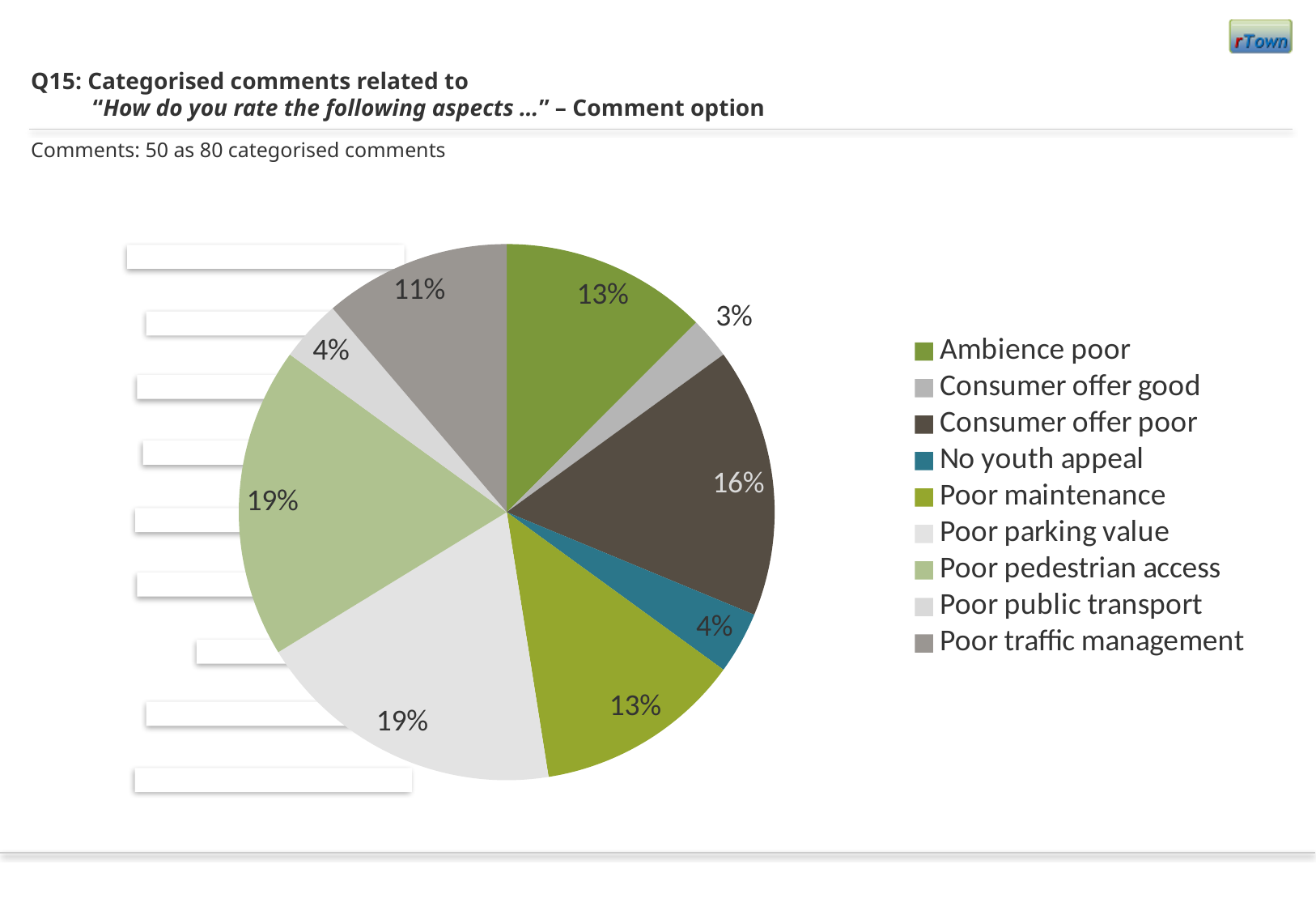
How many categories does the pie chart show? 9 What share of comments is labelled for Poor traffic management? 11% What share of comments is labelled for Consumer offer poor? 16% Which category has the smallest slice of the pie? Consumer offer good What kind of chart is shown on the slide? pie chart What share of comments is labelled for Poor pedestrian access? 19% What share of comments is labelled for No youth appeal? 4% How many entries does the legend list? 9 What is the difference in percentage points between Consumer offer poor and Ambience poor? 3 percentage points Which is larger, the slice for Consumer offer poor or the slice for Poor maintenance? Consumer offer poor What share of comments is labelled for Ambience poor? 13% Which legend entry is shown in teal blue? No youth appeal